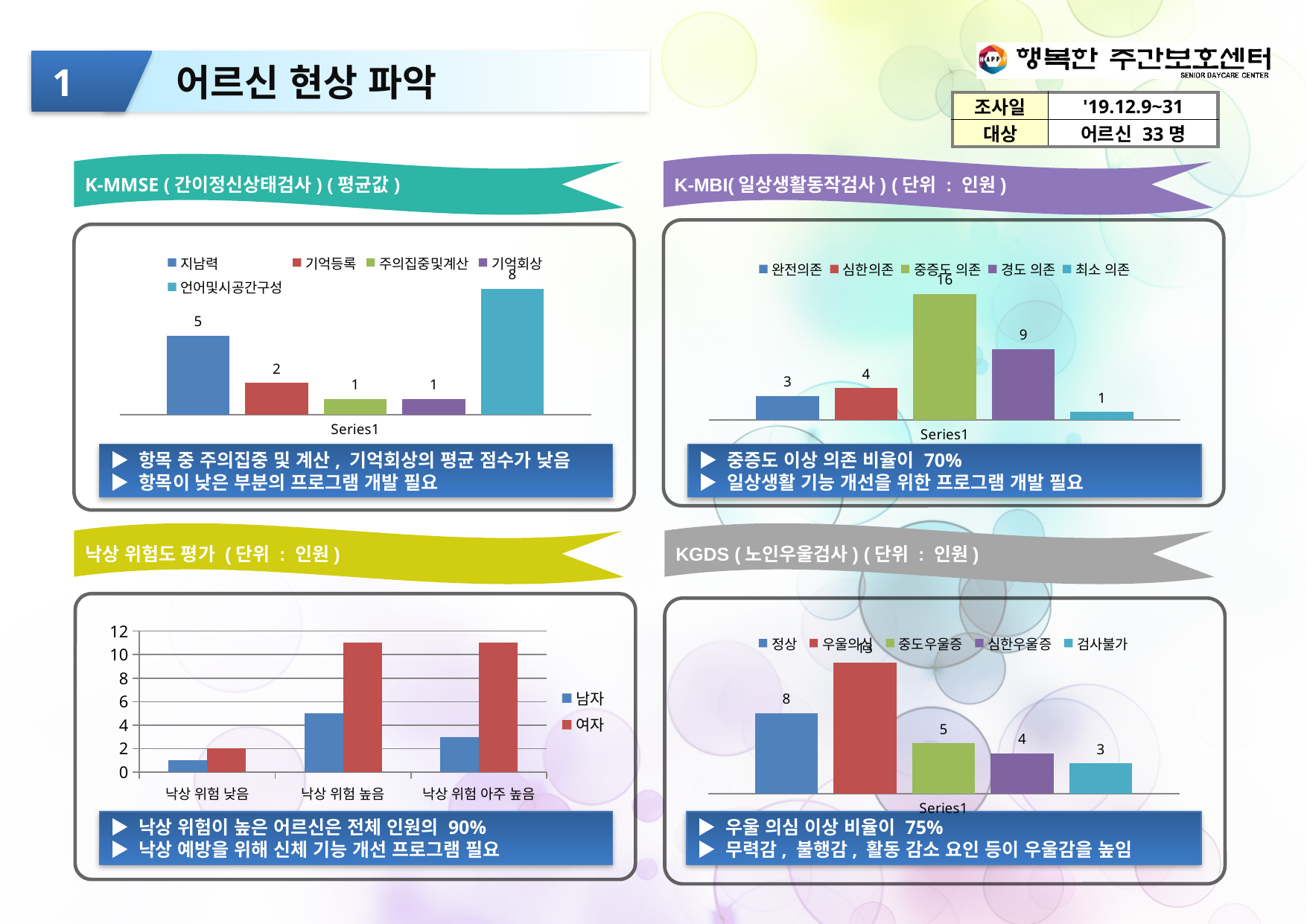
In the K-MMSE chart, what is the value for 지남력? 5 In the 낙상 위험도 평가 chart, how many categories are shown on the x axis? 3 In the K-MBI chart, what is the value for 중증도 의존? 16 In the K-MMSE chart, how many series does the legend list? 5 In the K-MMSE chart, which legend item has the highest value? 언어및시공간구성 In the 낙상 위험도 평가 chart, is the value for 여자 in 낙상 위험 높음 greater or less than 10? greater In the K-MBI chart, which is larger, the value for 경도 의존 or the value for 심한의존? 경도 의존 In the 낙상 위험도 평가 chart, what kind of chart is it? bar chart In the K-MMSE chart, what is the difference between the values for 언어및시공간구성 and 지남력? 3 In the K-MBI chart, which legend item has the lowest value? 최소 의존 In the K-MBI chart, what is the difference between the values for 중증도 의존 and 경도 의존? 7 In the KGDS chart, what is the value for 정상? 8